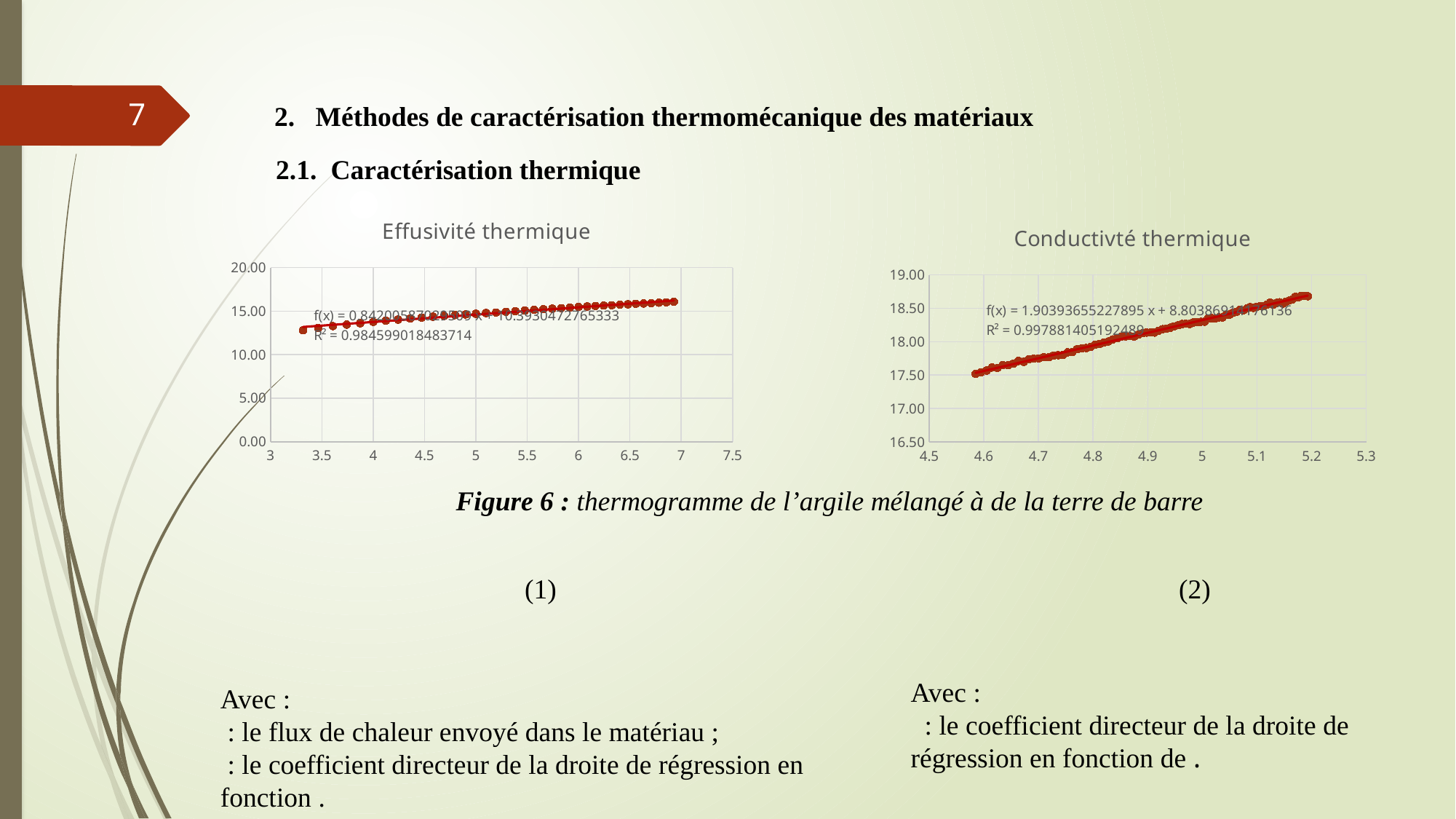
In the 'Effusivité thermique' chart, is the plotted value at x = 6.5 greater or less than 15.00? greater What is the title of the chart on the left of the slide? Effusivité thermique What is the title of the chart on the right of the slide? Conductivté thermique In the 'Effusivité thermique' chart, what R² value is shown for the trendline? 0.984599018483714 In the 'Conductivté thermique' chart, is the plotted value at x = 5.2 greater or less than 18.50? greater In the 'Effusivité thermique' chart, which has the larger plotted value: the point at x = 3.5 or the point at x = 6.5? x = 6.5 What kind of chart is the 'Effusivité thermique' chart? scatter chart In the 'Conductivté thermique' chart, do the plotted values rise or fall as x increases? rise In the 'Effusivité thermique' chart, is the plotted value at x = 3.5 greater or less than 15.00? less In the 'Effusivité thermique' chart, do the plotted values rise or fall as x increases? rise In the 'Conductivté thermique' chart, what is the slope (coefficient of x) in the displayed trendline equation? 1.90393655227895